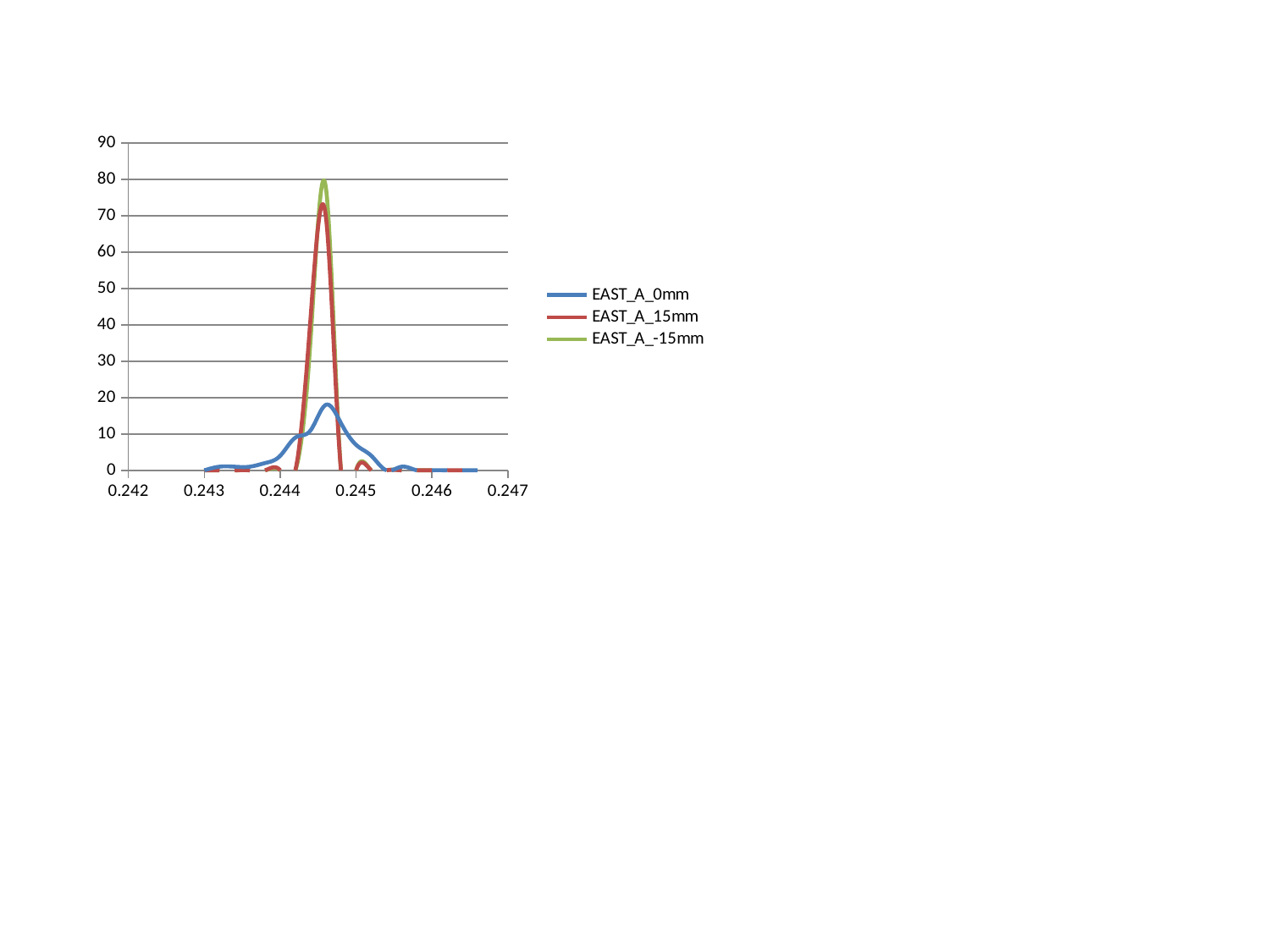
Is the peak value of EAST_A_0mm greater or less than 20? less Which series has the lowest peak value? EAST_A_0mm What kind of chart is shown on the slide? Line chart Is the peak value of EAST_A_-15mm greater or less than 70? greater Is the peak value of EAST_A_15mm greater or less than 60? greater How many series does the legend list? 3 What is the maximum value shown on the vertical axis? 90 Which series has a higher peak, EAST_A_0mm or EAST_A_15mm? EAST_A_15mm What colour is the line for EAST_A_0mm? Blue Which series reaches the highest peak value? EAST_A_-15mm